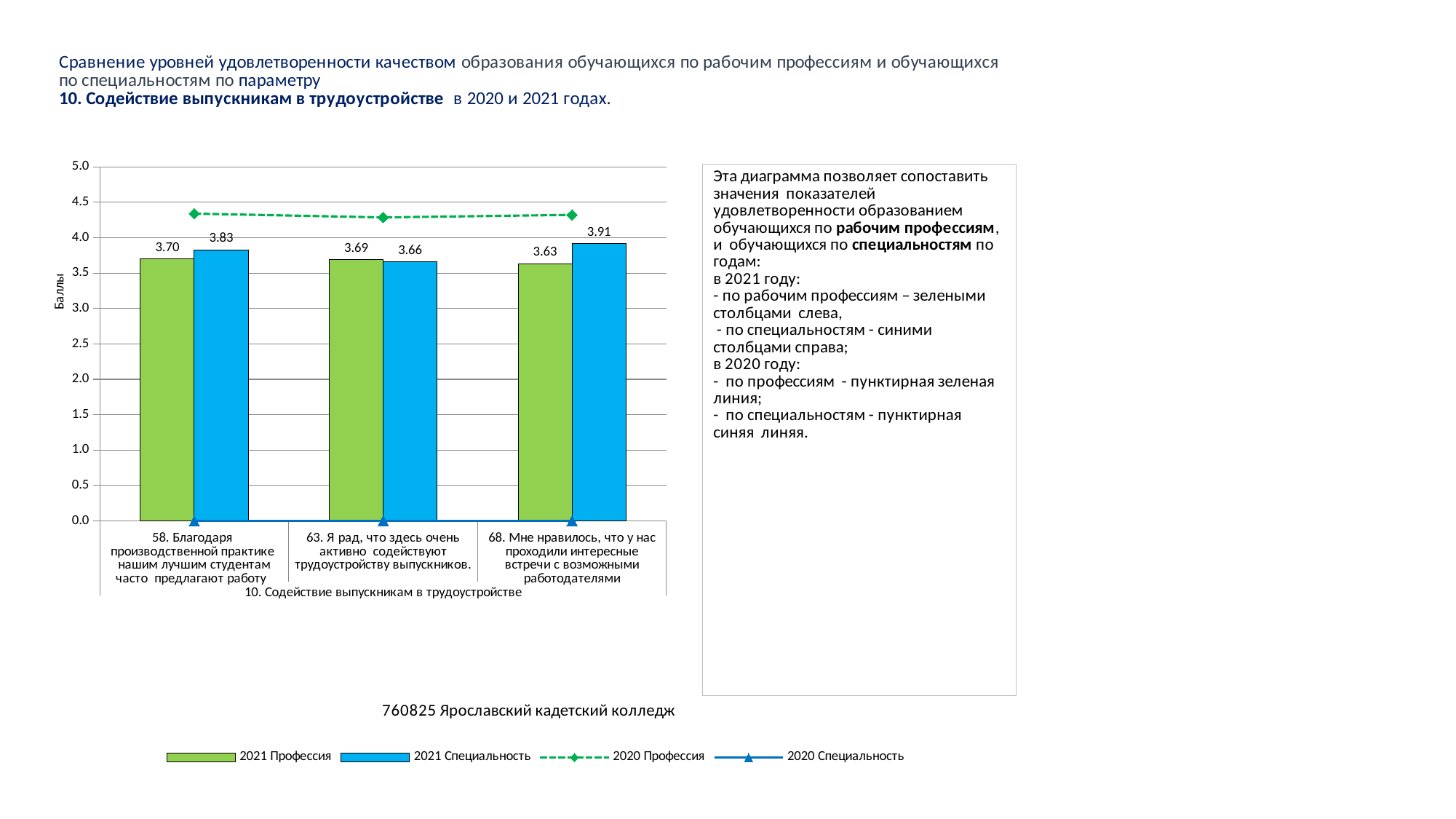
How many series does the legend list? 4 Which category has the highest 2021 Специальность value? 68. Мне нравилось, что у нас проходили интересные встречи с возможными работодателями What is the label of the y axis? Баллы For category 58, which is larger: the 2021 Профессия bar or the 2021 Специальность bar? 2021 Специальность What is the value of the 2021 Специальность bar for category 68 (Мне нравилось, что у нас проходили интересные встречи с возможными работодателями)? 3.91 What kind of chart is this? Bar chart with line series How many categories are shown on the x axis? 3 What is the difference between the 2021 Специальность and 2021 Профессия values for category 68? 0.28 Is the 2020 Профессия value for category 58 greater or less than 4.0? greater What is the value of the 2021 Профессия bar for category 58 (Благодаря производственной практике нашим лучшим студентам часто предлагают работу)? 3.70 What is the value of the 2021 Специальность bar for category 63 (Я рад, что здесь очень активно содействуют трудоустройству выпускников)? 3.66 Which category has the lowest 2021 Профессия value? 68. Мне нравилось, что у нас проходили интересные встречи с возможными работодателями